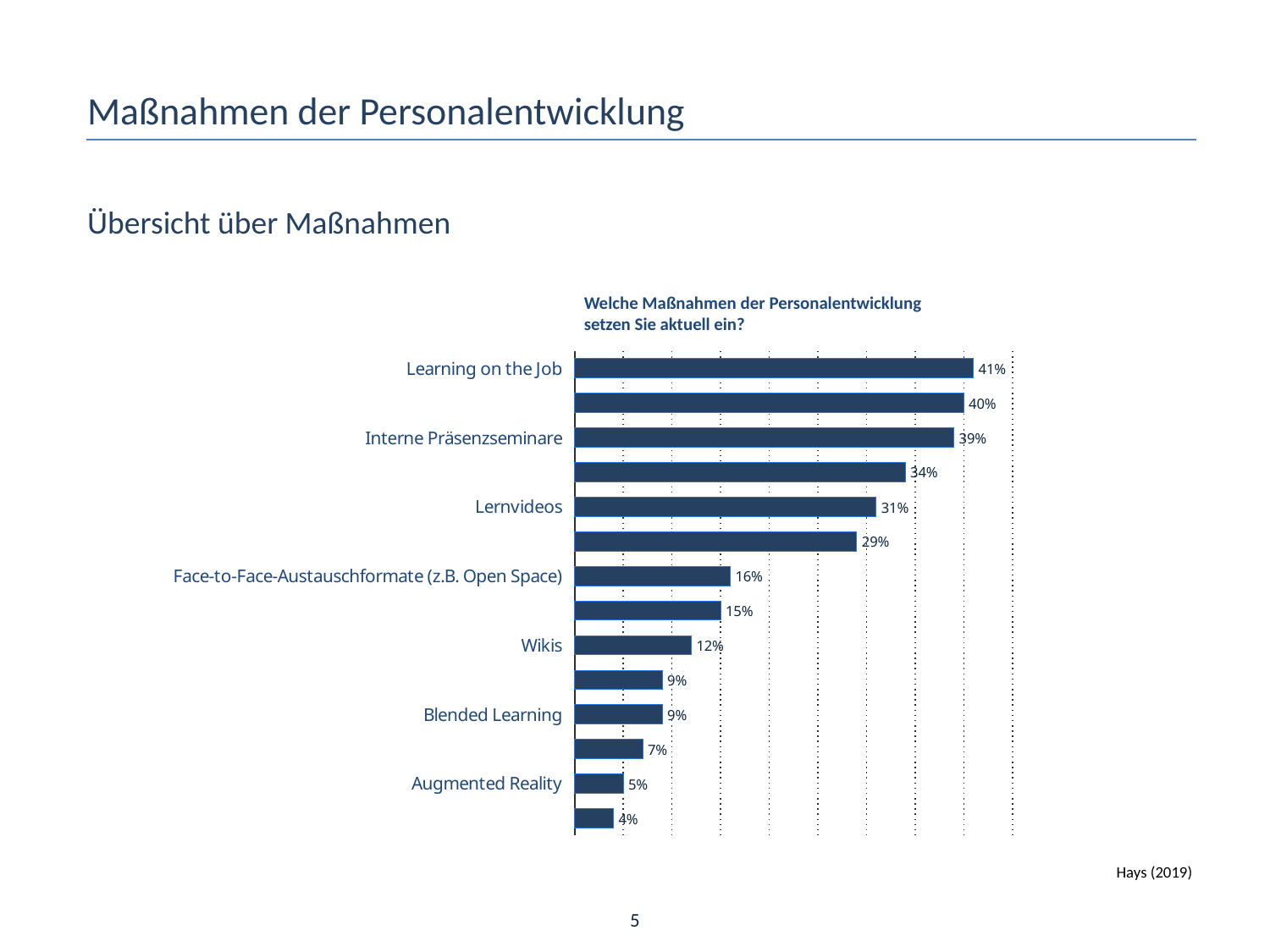
What is the value for Interne Präsenzseminare? 39% What is the difference between the values for Learning on the Job and Lernvideos? 10% What kind of chart is shown on the slide? Bar chart What is the lowest value shown in the chart? 4% How many bars are shown in the chart? 14 What is the value for Face-to-Face-Austauschformate (z.B. Open Space)? 16% What is the value for Wikis? 12% Which labelled category has the highest value? Learning on the Job What is the value for Augmented Reality? 5% What is the value for Lernvideos? 31% What is the value for Learning on the Job? 41% Which is larger, the value for Wikis or the value for Blended Learning? Wikis